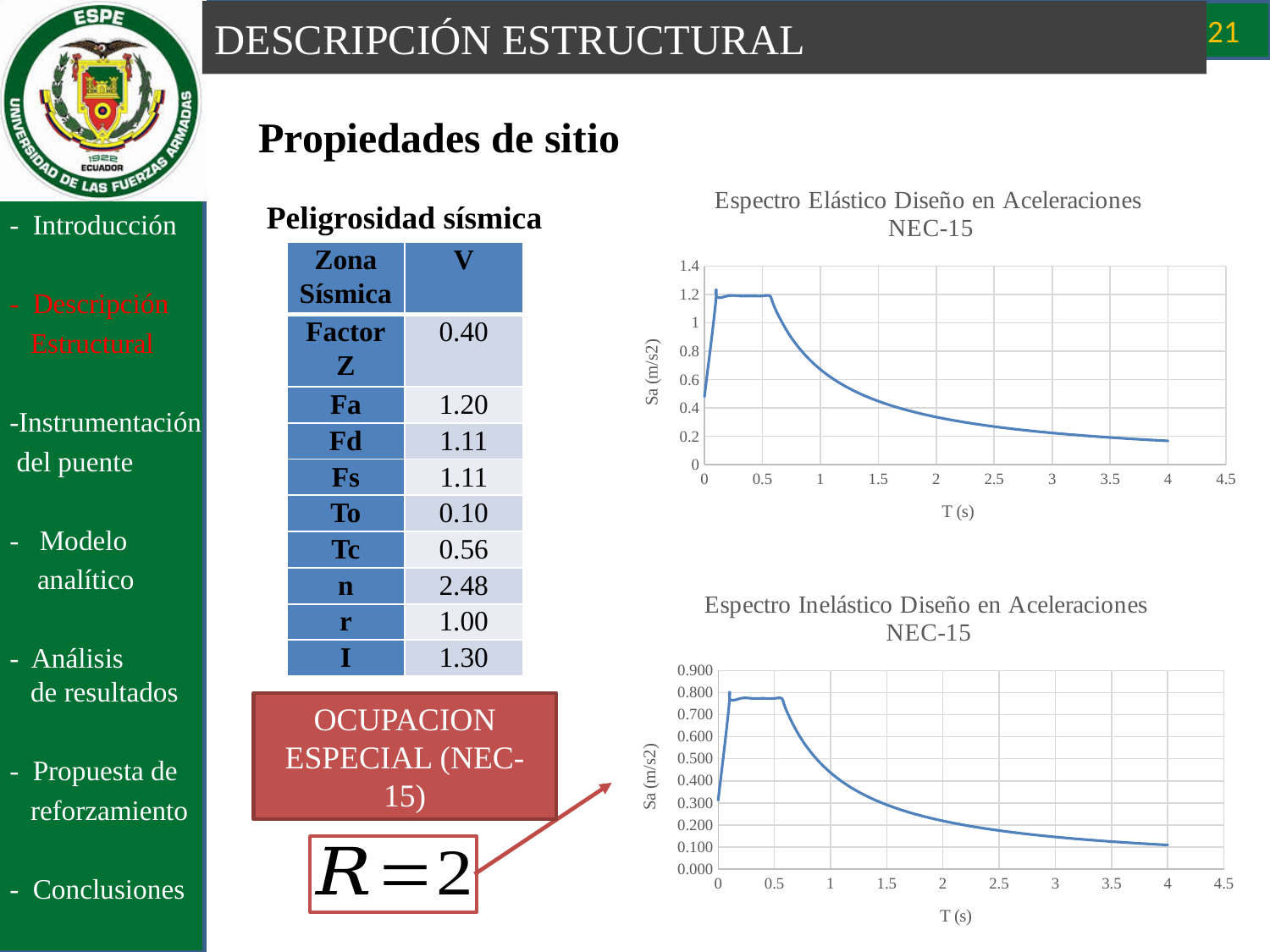
In the 'Espectro Inelástico Diseño en Aceleraciones NEC-15' chart, is the value of Sa at T = 0.5 s greater or less than 0.600? greater What kind of chart is the 'Espectro Inelástico Diseño en Aceleraciones NEC-15' chart? line chart In the 'Espectro Inelástico Diseño en Aceleraciones NEC-15' chart, what is the highest tick value shown on the y axis? 0.900 What kind of chart is the 'Espectro Elástico Diseño en Aceleraciones NEC-15' chart? line chart In the 'Espectro Inelástico Diseño en Aceleraciones NEC-15' chart, what is the label of the y axis? Sa (m/s2) In the 'Espectro Inelástico Diseño en Aceleraciones NEC-15' chart, is the value of Sa at T = 4 s greater or less than 0.200? less How many data series are plotted in the 'Espectro Elástico Diseño en Aceleraciones NEC-15' chart? 1 In the 'Espectro Inelástico Diseño en Aceleraciones NEC-15' chart, does the curve rise or fall as T increases from 1 s to 4 s? fall In the 'Espectro Elástico Diseño en Aceleraciones NEC-15' chart, what is the label of the x axis? T (s) In the 'Espectro Elástico Diseño en Aceleraciones NEC-15' chart, does the curve rise or fall as T increases from 1 s to 4 s? fall In the 'Espectro Elástico Diseño en Aceleraciones NEC-15' chart, is the value of Sa at T = 0.5 s greater or less than 1? greater